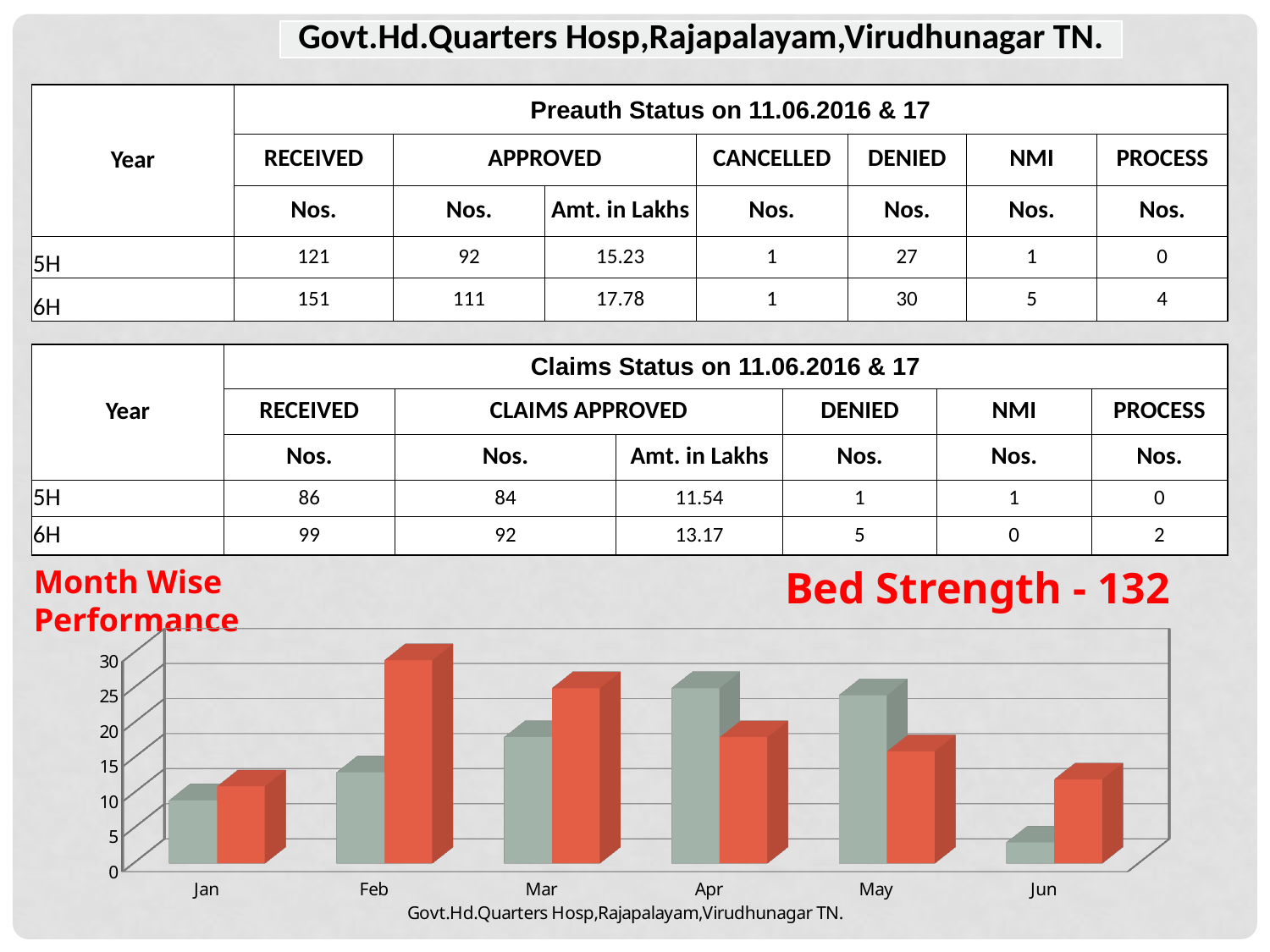
What text appears directly below the x axis of the bar chart? Govt.Hd.Quarters Hosp,Rajapalayam,Virudhunagar TN. In the bar chart, is the red bar for May greater or less than 20? less In the bar chart, is the red bar for Mar greater or less than 20? greater In the bar chart, which bar is taller for Apr, the grey bar or the red bar? the grey bar In the bar chart, which month has the shortest grey bar? Jun In the bar chart, which month has the tallest red bar? Feb In the bar chart, is the red bar for Feb greater or less than 25? greater How many months are shown on the x axis of the bar chart? 6 In the bar chart, which bar is taller for Feb, the grey bar or the red bar? the red bar What kind of chart is shown at the bottom of the slide? bar chart